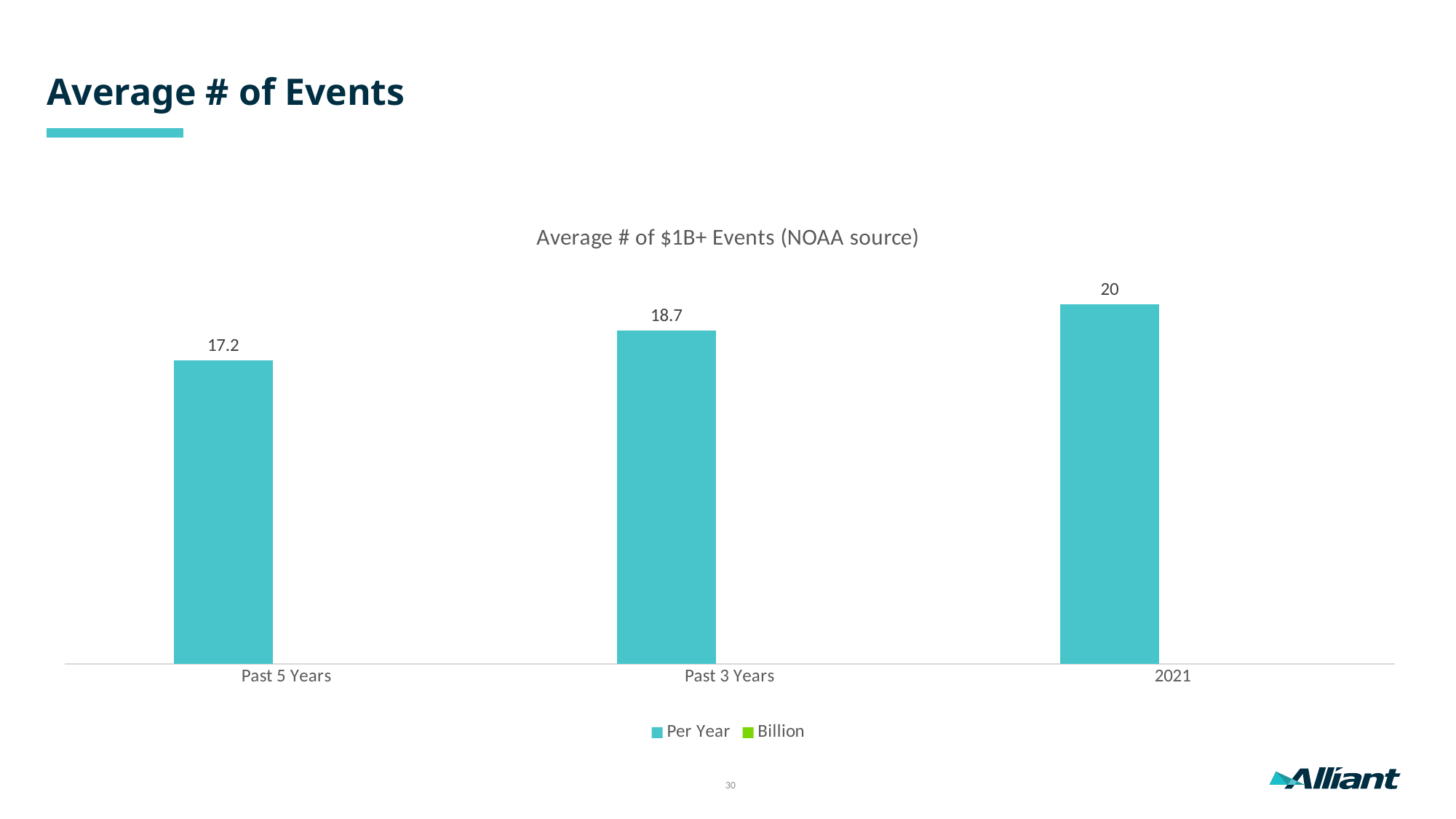
Which category has the highest value? 2021 What kind of chart is shown? Bar chart What is the difference between the values for 2021 and Past 5 Years? 2.8 Which is larger, the value for Past 3 Years or the value for 2021? 2021 How many categories are shown on the x axis? 3 Which category has the lowest value? Past 5 Years What is the value for Past 3 Years? 18.7 What is the value for 2021? 20 How many series does the legend list? 2 Do the values rise or fall from Past 5 Years to 2021? Rise What is the difference between the values for Past 3 Years and Past 5 Years? 1.5 What is the value for Past 5 Years? 17.2